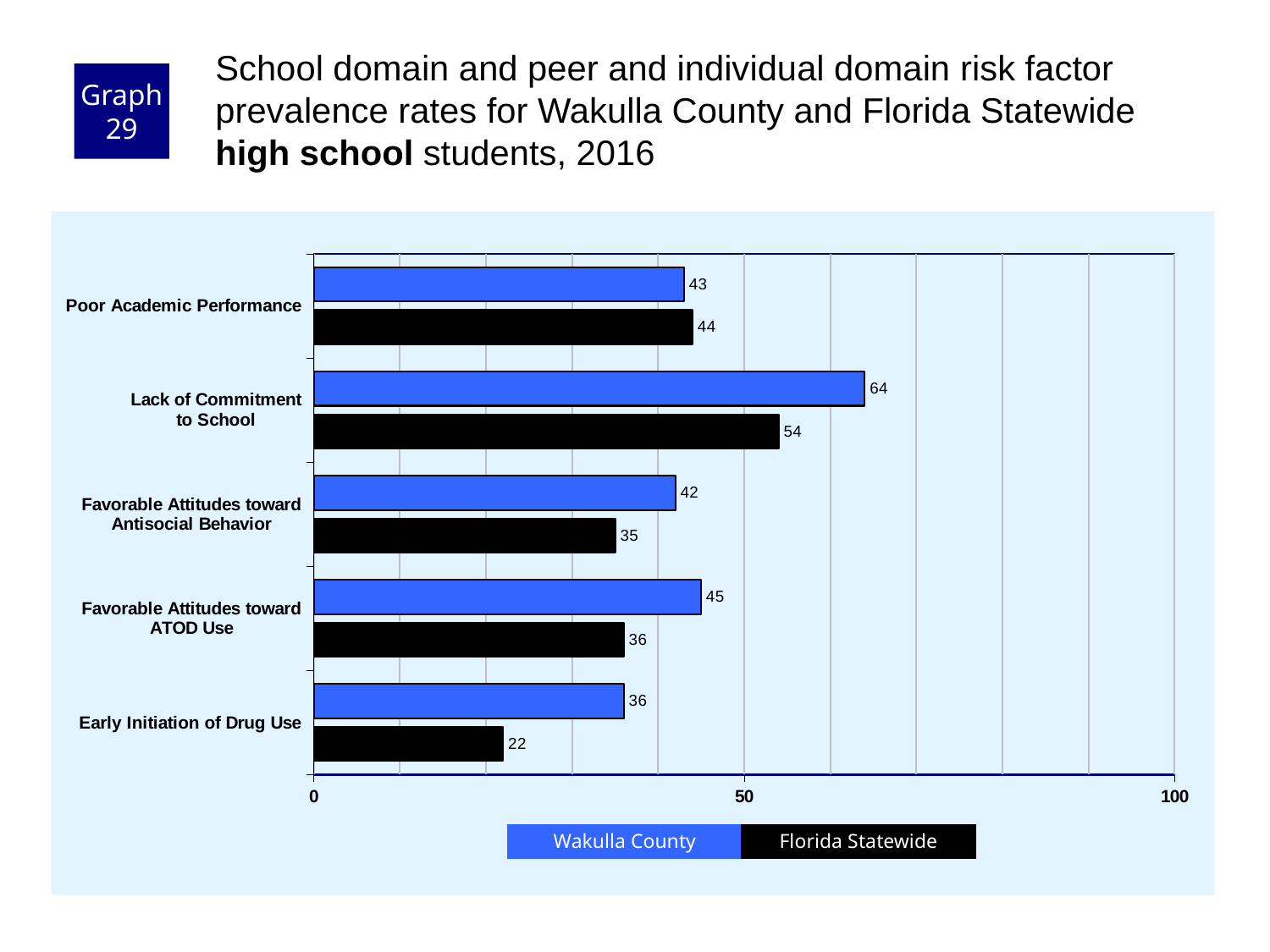
What kind of chart is shown on the slide? bar chart What is the Florida Statewide value for Early Initiation of Drug Use? 22 What is the Wakulla County value for Lack of Commitment to School? 64 Which category has the highest Wakulla County value? Lack of Commitment to School Which category has the lowest Florida Statewide value? Early Initiation of Drug Use What is the Florida Statewide value for Favorable Attitudes toward ATOD Use? 36 How many series does the legend list? 2 How many risk factor categories are shown on the chart? 5 Which is larger for Poor Academic Performance, the Wakulla County value or the Florida Statewide value? Florida Statewide What is the difference between the Wakulla County and Florida Statewide values for Early Initiation of Drug Use? 14 What is the difference between the Wakulla County and Florida Statewide values for Lack of Commitment to School? 10 Is the Wakulla County value for Lack of Commitment to School greater or less than 50? greater